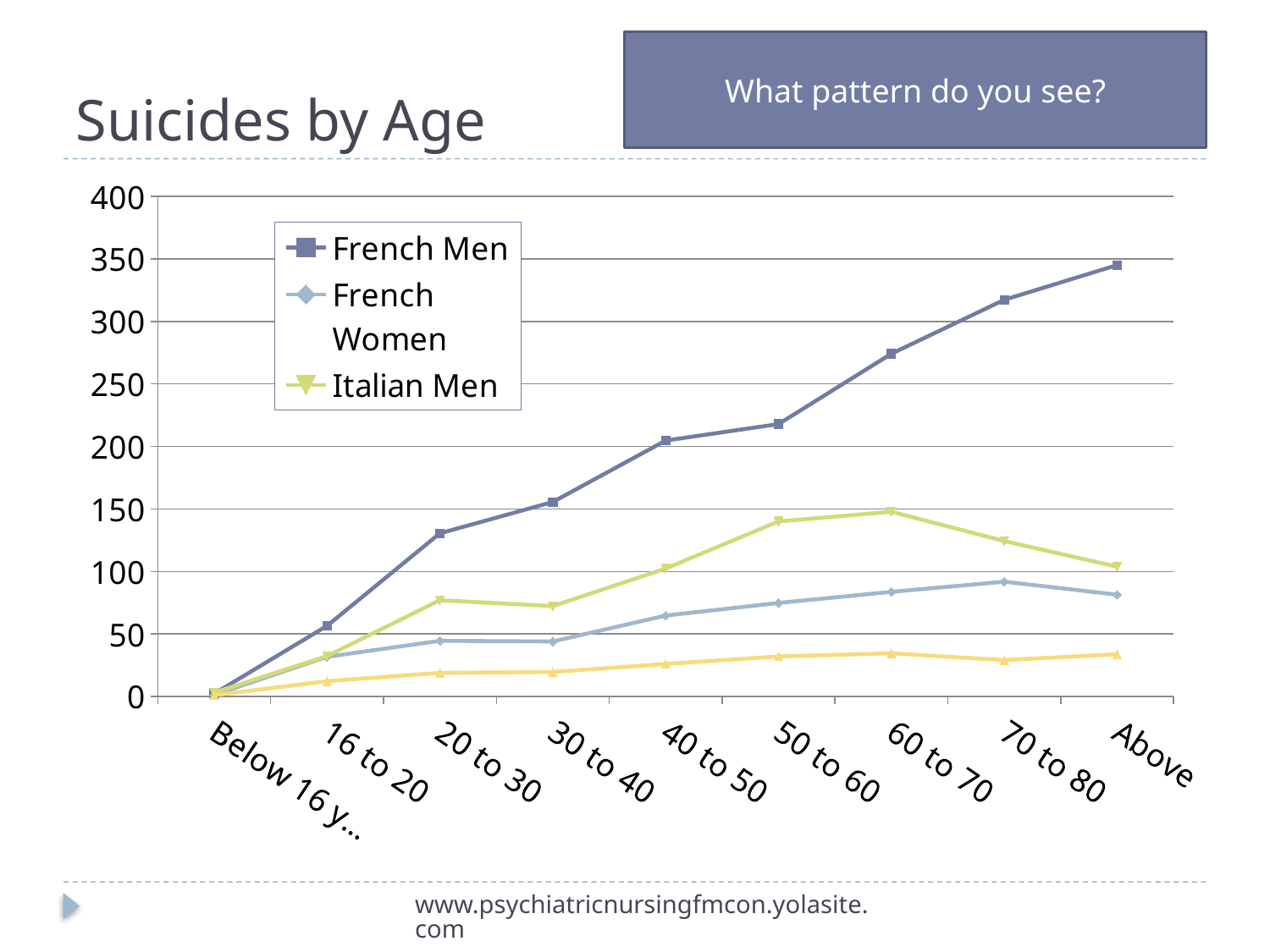
Is the value for French Men in the 20 to 30 category greater or less than 100? greater Which age category has the highest value for French Men? Above How many series does the legend list? 3 What is the title of the chart? Suicides by Age Is the value for French Women in the 70 to 80 category greater or less than 100? less In the 50 to 60 category, which is larger: Italian Men or French Women? Italian Men Is the value for French Men in the Above category greater or less than 300? greater Which age category has the highest value for Italian Men? 60 to 70 What kind of chart is shown on the slide? line chart Do the values for French Men rise or fall as age increases along the x axis? rise How many age categories are shown on the x axis? 9